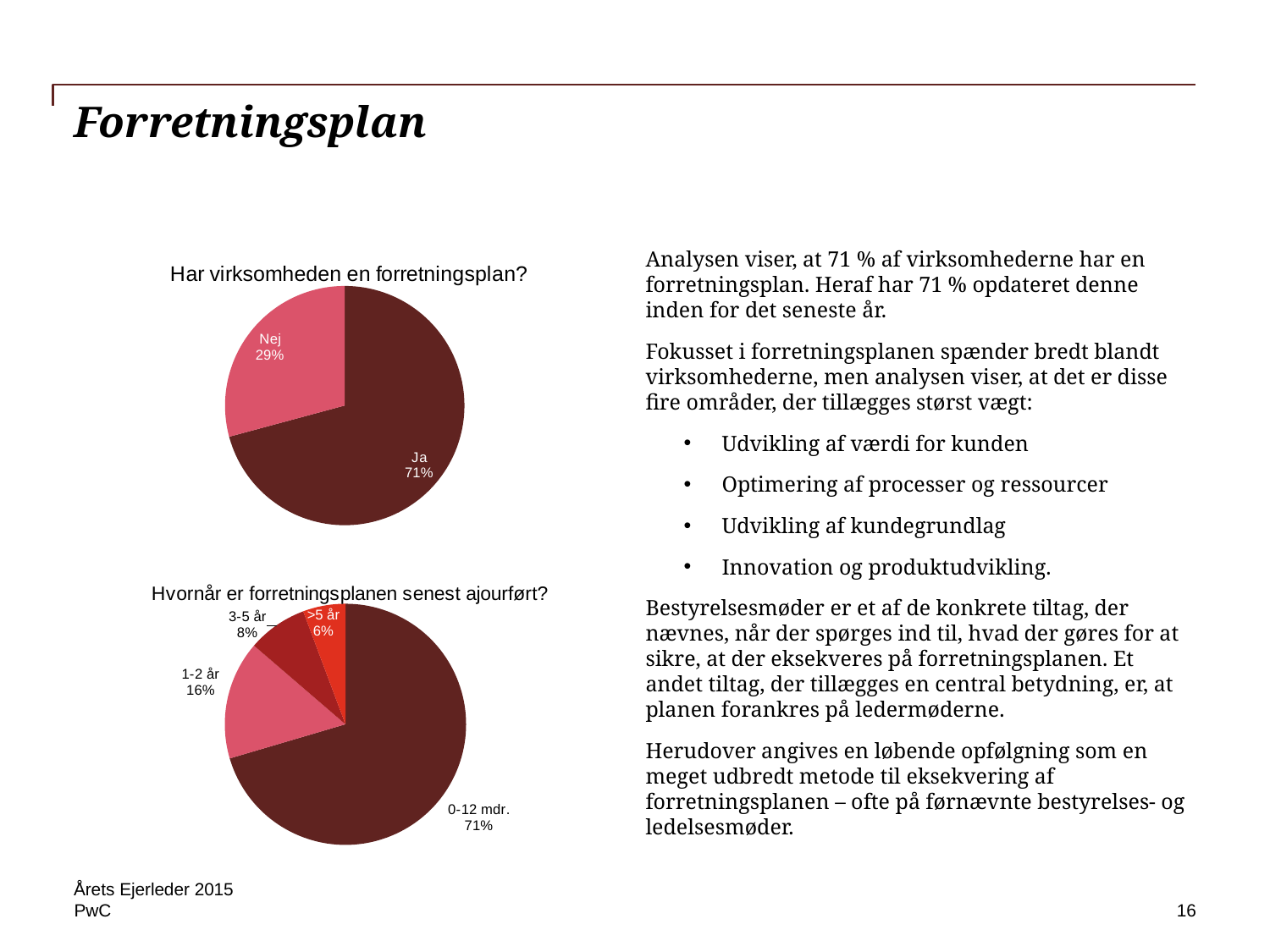
In the chart titled "Har virksomheden en forretningsplan?", which slice is the largest? Ja In the chart titled "Hvornår er forretningsplanen senest ajourført?", which is larger: "1-2 år" or "3-5 år"? 1-2 år In the chart titled "Hvornår er forretningsplanen senest ajourført?", which category has the largest slice? 0-12 mdr. In the chart titled "Har virksomheden en forretningsplan?", what share of the pie is "Ja"? 71% In the chart titled "Hvornår er forretningsplanen senest ajourført?", how many categories are shown? 4 In the chart titled "Har virksomheden en forretningsplan?", what is the difference between "Ja" and "Nej"? 42% In the chart titled "Hvornår er forretningsplanen senest ajourført?", what is the value for "3-5 år"? 8% In the chart titled "Har virksomheden en forretningsplan?", how many slices does the pie have? 2 In the chart titled "Hvornår er forretningsplanen senest ajourført?", which category has the smallest slice? >5 år In the chart titled "Hvornår er forretningsplanen senest ajourført?", what is the value for "1-2 år"? 16% What kind of chart is the chart titled "Hvornår er forretningsplanen senest ajourført?"? Pie chart In the chart titled "Har virksomheden en forretningsplan?", what is the value for "Nej"? 29%